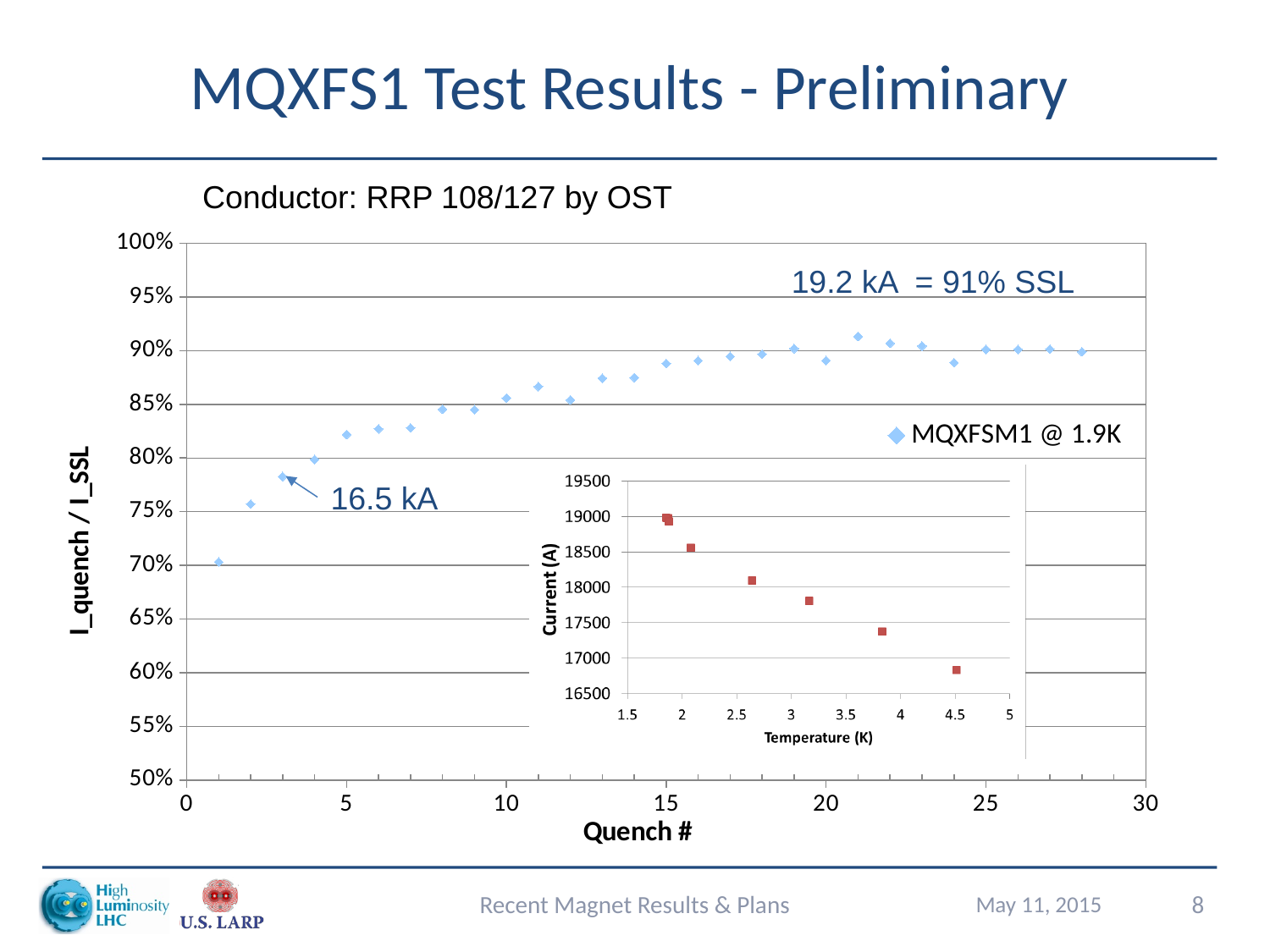
According to the annotation on the main chart, what percentage of SSL does 19.2 kA correspond to? 91% In the main chart (I_quench / I_SSL vs Quench #), is the value for quench 1 greater or less than 75%? less What kind of chart is the main chart plotting I_quench / I_SSL against Quench #? scatter chart In the main chart (I_quench / I_SSL vs Quench #), how many series does the legend list? 1 In the main chart (I_quench / I_SSL vs Quench #), what is the legend entry for the plotted series? MQXFSM1 @ 1.9K In the inset chart (Current (A) vs Temperature (K)), does the current rise or fall as temperature increases? fall In the main chart (I_quench / I_SSL vs Quench #), which quench number has the highest value? 21 In the main chart (I_quench / I_SSL vs Quench #), do the values generally rise or fall as the quench number increases? rise In the main chart (I_quench / I_SSL vs Quench #), is the value for quench 21 greater or less than 90%? greater In the inset chart (Current (A) vs Temperature (K)), is the current at the highest plotted temperature (about 4.5 K) greater or less than 17000? less What kind of chart is the inset chart plotting Current (A) against Temperature (K)? scatter chart In the main chart (I_quench / I_SSL vs Quench #), which quench number has the lowest value? 1